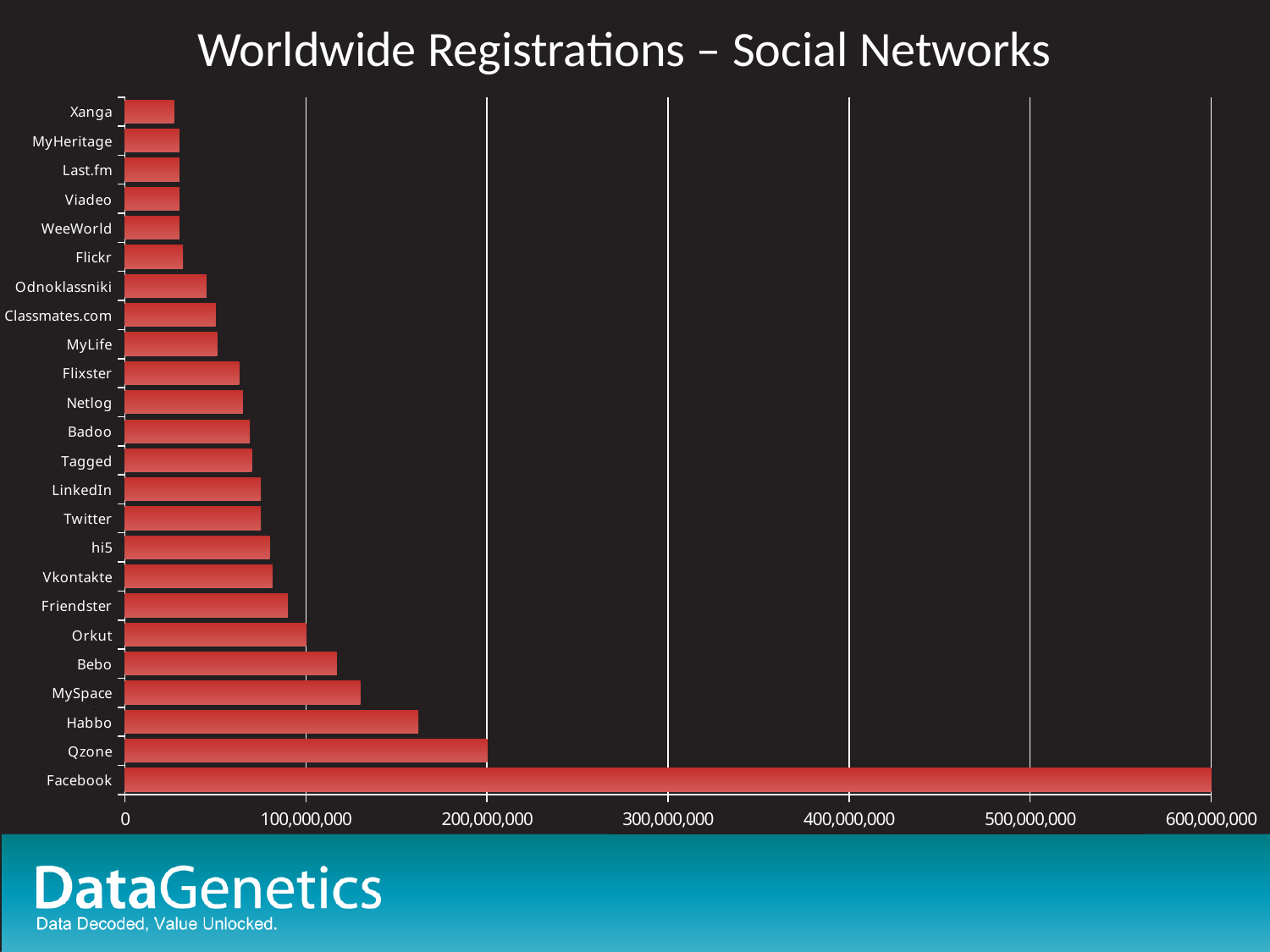
Is the value for Habbo greater or less than 100,000,000? greater Which has more registrations, Habbo or MySpace? Habbo What is the title of the chart? Worldwide Registrations – Social Networks Is the value for Habbo greater or less than 200,000,000? less How many social networks are listed on the chart? 24 What is the value for Qzone? 200,000,000 Which social network has the highest number of worldwide registrations? Facebook Is the value for Friendster greater or less than 100,000,000? less What is the value for Orkut? 100,000,000 What is the difference between the values for Facebook and Qzone? 400,000,000 What kind of chart is shown on the slide? bar chart What is the value for Facebook? 600,000,000